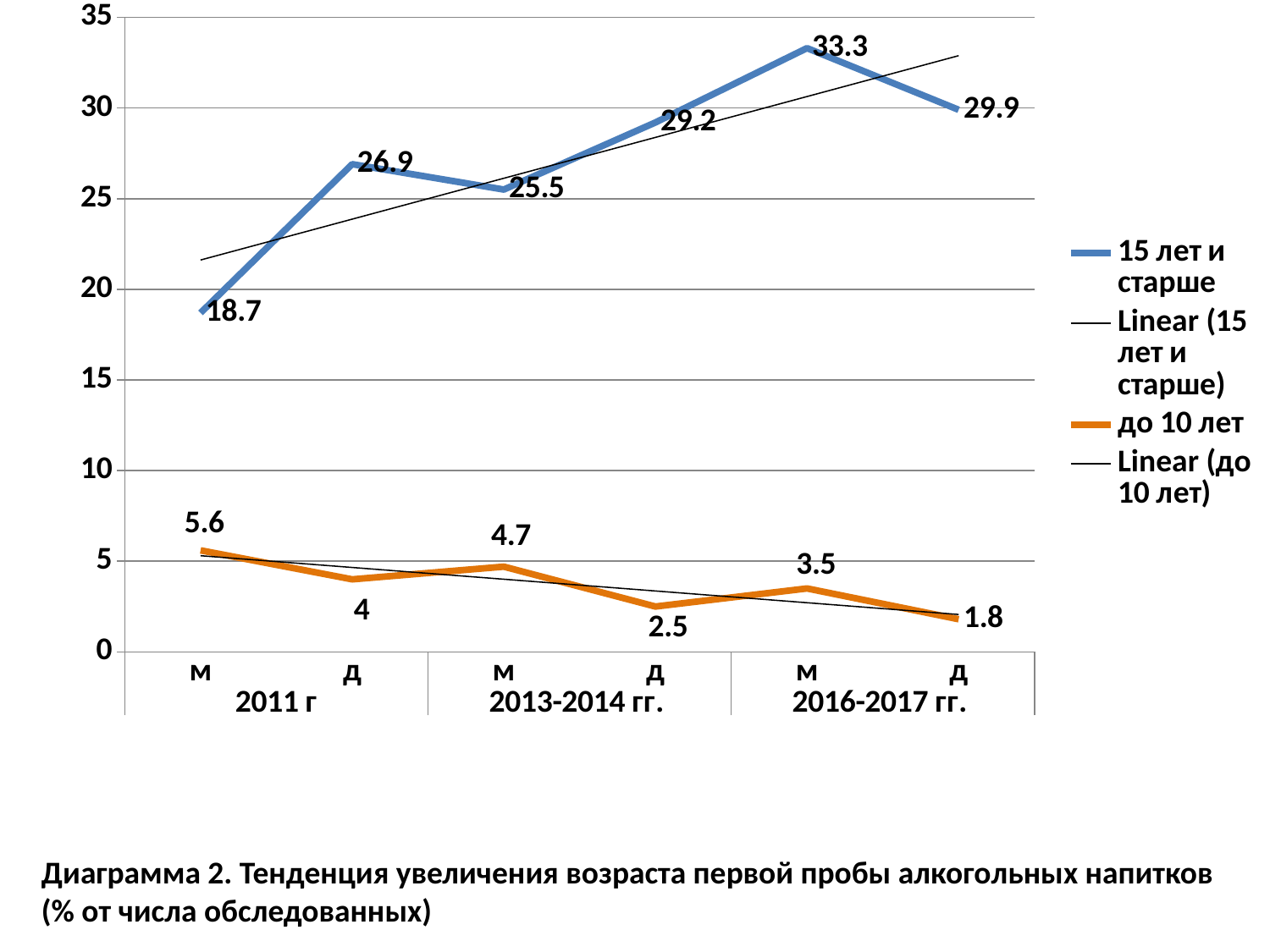
What is the value for "15 лет и старше" for м in 2011 г? 18.7 How many data points are plotted for the "15 лет и старше" series? 6 Does the "до 10 лет" series generally rise or fall from 2011 г to 2016-2017 гг.? fall What colour is the line for the "до 10 лет" series? orange What is the difference between the "15 лет и старше" values for м in 2016-2017 гг. and м in 2011 г? 14.6 Which data point has the highest value for the "15 лет и старше" series? м, 2016-2017 гг. (33.3) Which is larger for "до 10 лет": the value for м in 2011 г or the value for м in 2013-2014 гг.? м in 2011 г (5.6) Which data point has the lowest value for the "до 10 лет" series? д, 2016-2017 гг. (1.8) What type of chart is shown on the slide? line chart How many entries does the legend list? 4 What is the value for "до 10 лет" for д in 2016-2017 гг.? 1.8 What is the value for "15 лет и старше" for д in 2013-2014 гг.? 29.2